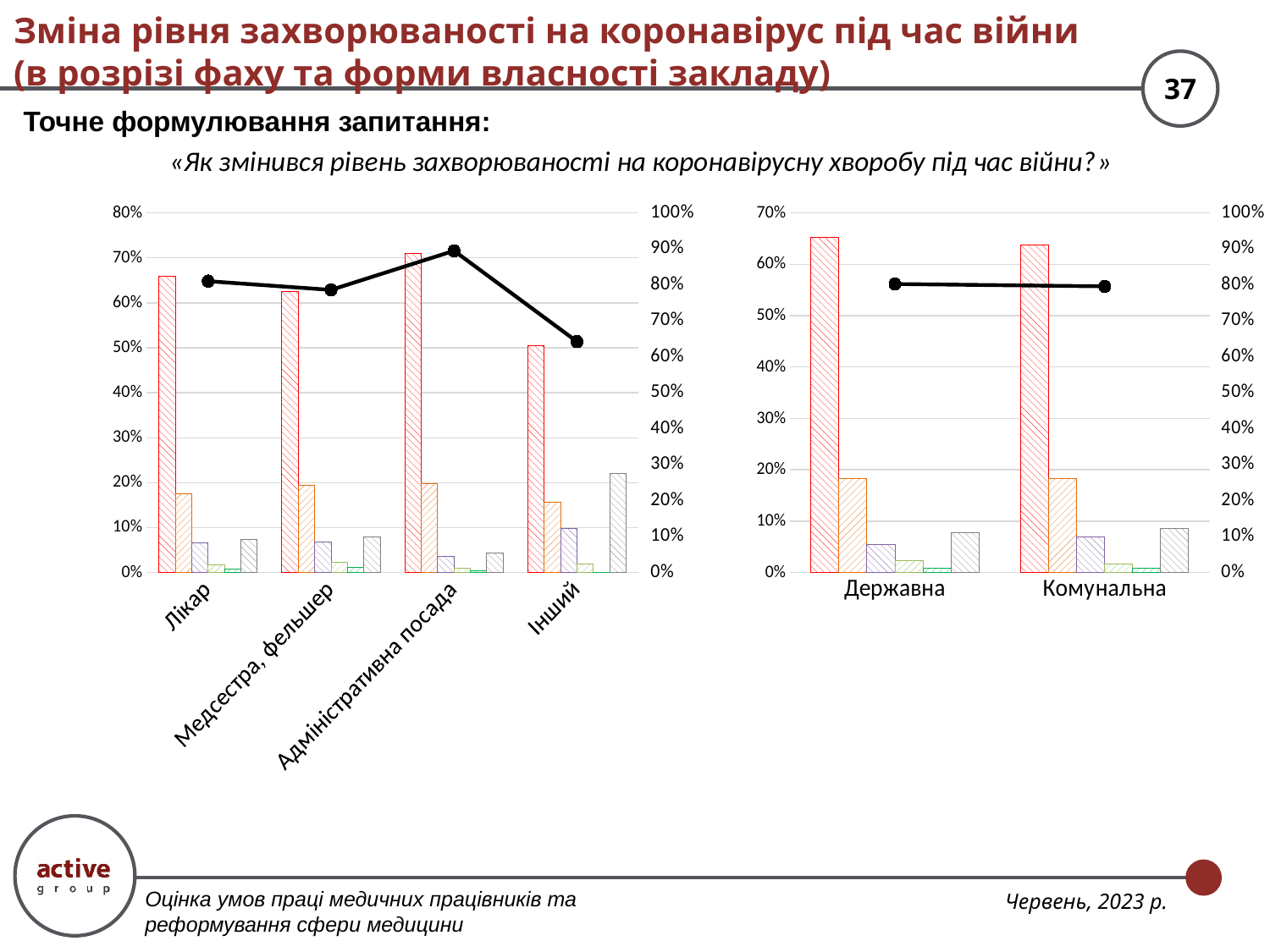
In the left chart (by profession), is the red bar for Інший greater or less than 60%? less In the left chart (by profession), which category has the tallest red bar? Адміністративна посада How many categories are shown on the x axis of the left chart (by profession)? 4 What kind of chart is the left chart (by profession)? bar chart with a line In the left chart (by profession), is the red bar for Лікар greater or less than 60%? greater In the left chart (by profession), is the black line value for Інший greater or less than 70% on the right-hand axis? less What are the two categories on the x axis of the right chart? Державна and Комунальна In the left chart (by profession), which has the taller red bar: Лікар or Інший? Лікар In the left chart (by profession), at which category does the black line reach its lowest point? Інший How many categories are shown on the x axis of the right chart (by form of ownership)? 2 In the left chart (by profession), which category has the shortest red bar? Інший